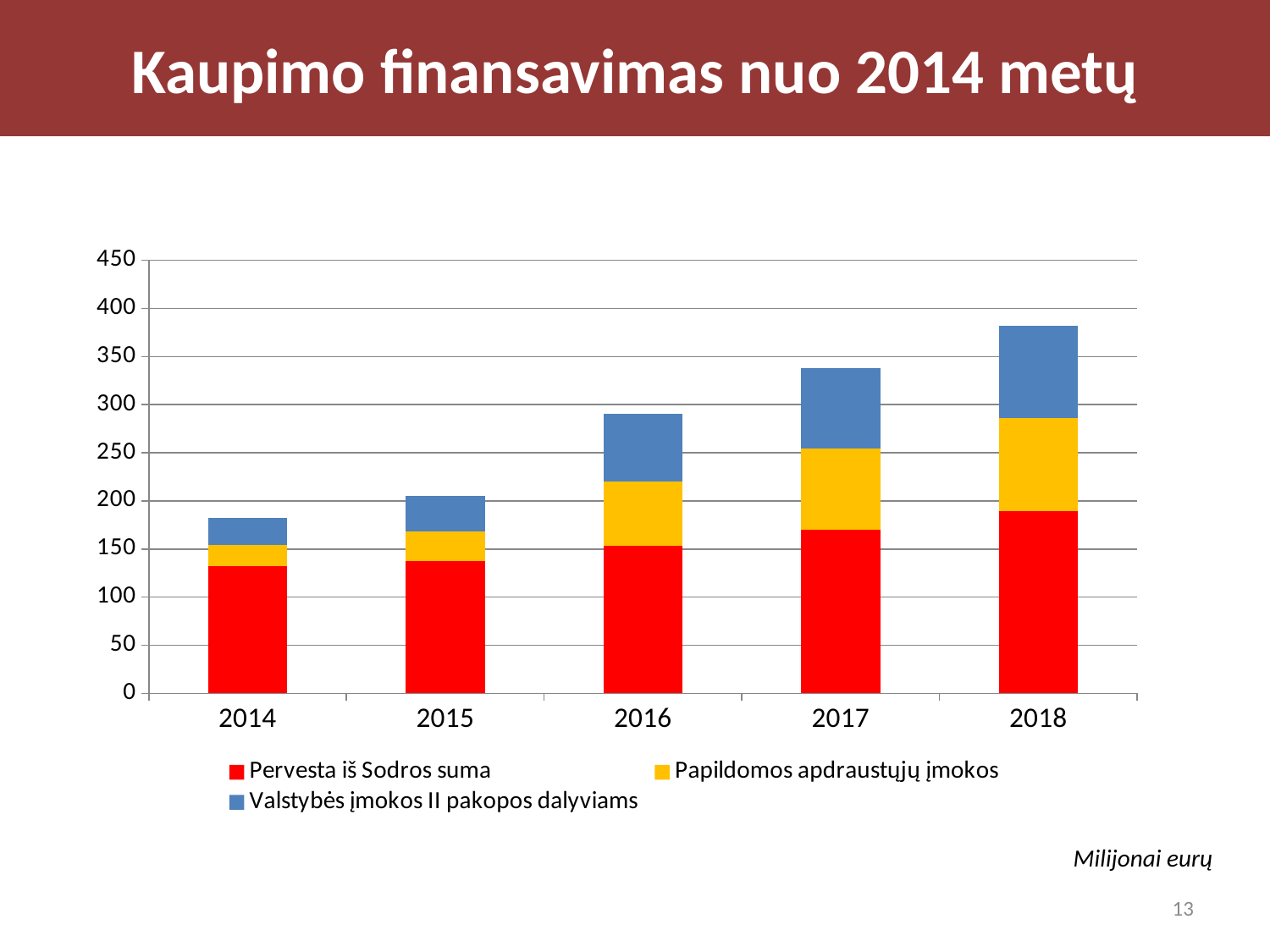
Which year has the lowest total bar? 2014 Which colour represents 'Valstybės įmokos II pakopos dalyviams' in the chart? blue Is the total bar for 2014 greater or less than 200? less How many series does the chart legend list? 3 Which year has the highest total bar? 2018 Is the total bar for 2018 greater or less than 350? greater Is the 'Pervesta iš Sodros suma' segment for 2018 greater or less than 150? greater How many years are shown on the x axis of the chart? 5 Do the total bar heights rise or fall from 2014 to 2018? rise What kind of chart is shown on the slide? stacked bar chart Which year has the larger total bar, 2015 or 2017? 2017